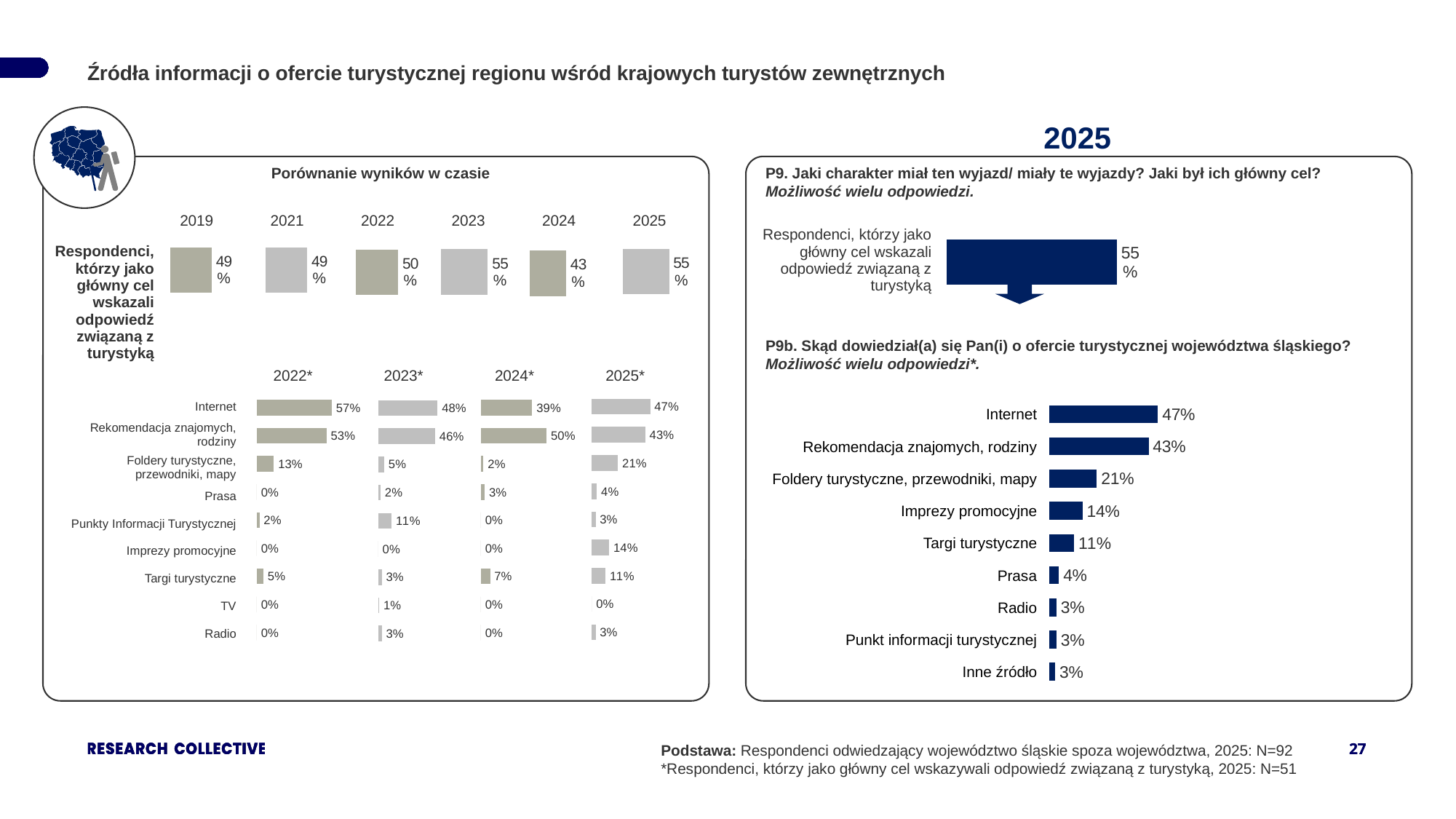
In the 2025 P9b bar chart on the right, how many categories are shown? 9 In the 2025 P9b bar chart on the right, what kind of chart is used? Bar chart In the 2025 P9b bar chart on the right, what is the difference between Internet and Rekomendacja znajomych, rodziny? 4% In the 'Porównanie wyników w czasie' panel, how many years are compared in the top row of bars? 6 In the 'Porównanie wyników w czasie' panel, which year has the lowest share of respondents indicating a tourism-related main goal? 2024 In the 'Porównanie wyników w czasie' panel, what is the difference between the Internet values for 2022* and 2024*? 18% In the 'Porównanie wyników w czasie' panel, what was the value for Internet in 2022*? 57% In the 2025 P9b bar chart on the right, which category has the highest value? Internet In the 2025 P9b bar chart on the right, which is larger: Imprezy promocyjne or Targi turystyczne? Imprezy promocyjne In the 'Porównanie wyników w czasie' panel, what was the value for Foldery turystyczne, przewodniki, mapy in 2025*? 21% In the 2025 P9b bar chart on the right, what is the value for Internet? 47% In the 'Porównanie wyników w czasie' panel, what share of respondents indicated a tourism-related main goal in 2024? 43%